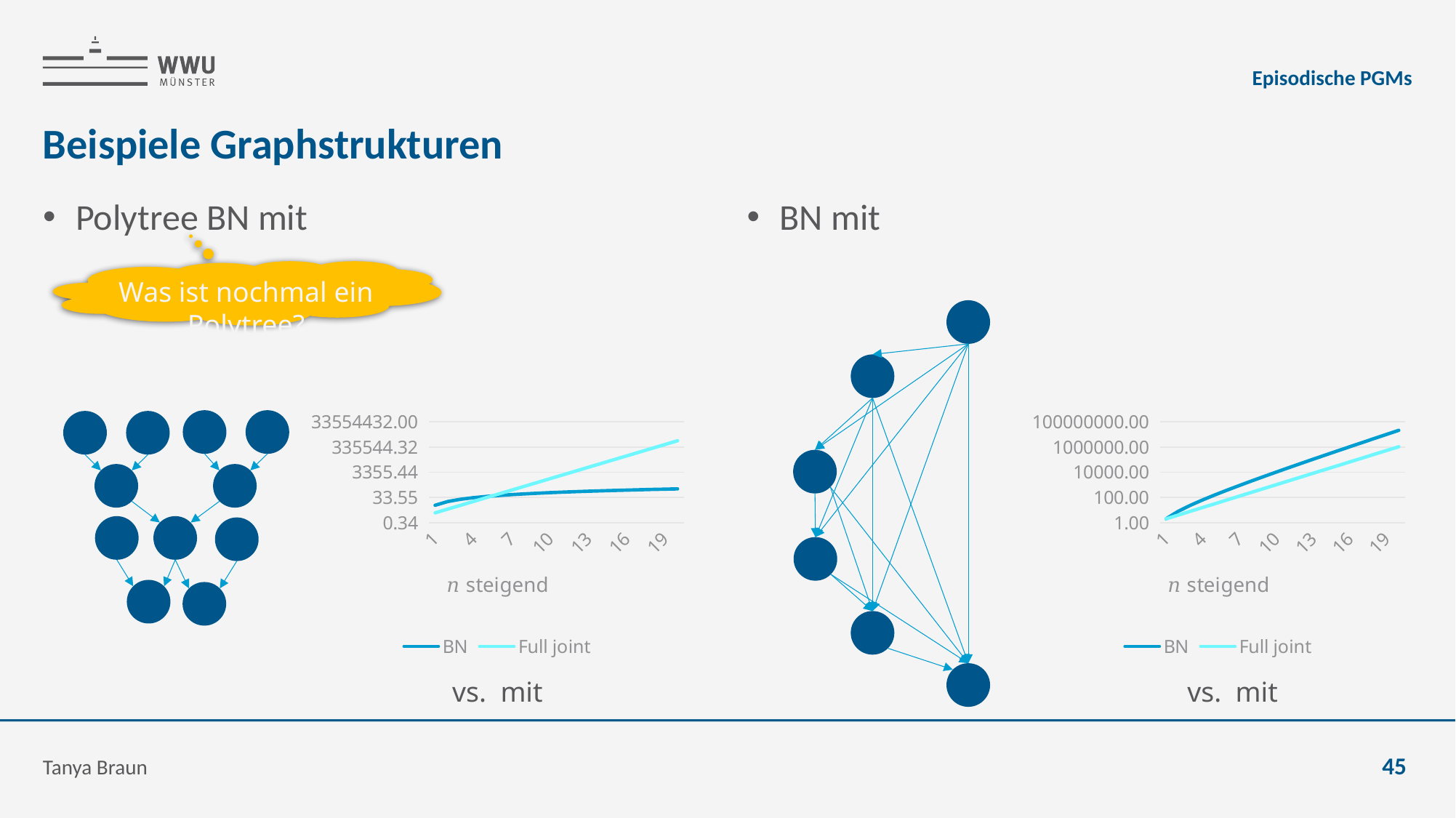
In the right chart, is the value of Full joint at n = 19 greater or less than 10000.00? greater In the left chart, which series is higher at n = 1, BN or Full joint? BN In the right chart, do the BN values rise or fall as n increases? rise In the left chart, is the value of Full joint at n = 19 greater or less than 3355.44? greater Which series are listed in the legend of the right chart? BN, Full joint What is the x-axis label of the left chart? n steigend What kind of chart is the right chart (next to the fully connected BN)? line chart How many series does the legend of the left chart list? 2 In the left chart, is the value of BN at n = 19 greater or less than 335544.32? less In the right chart, which series is higher at n = 19, BN or Full joint? BN In the left chart, which series is higher at n = 19, BN or Full joint? Full joint What kind of chart is the left chart (next to the polytree BN)? line chart